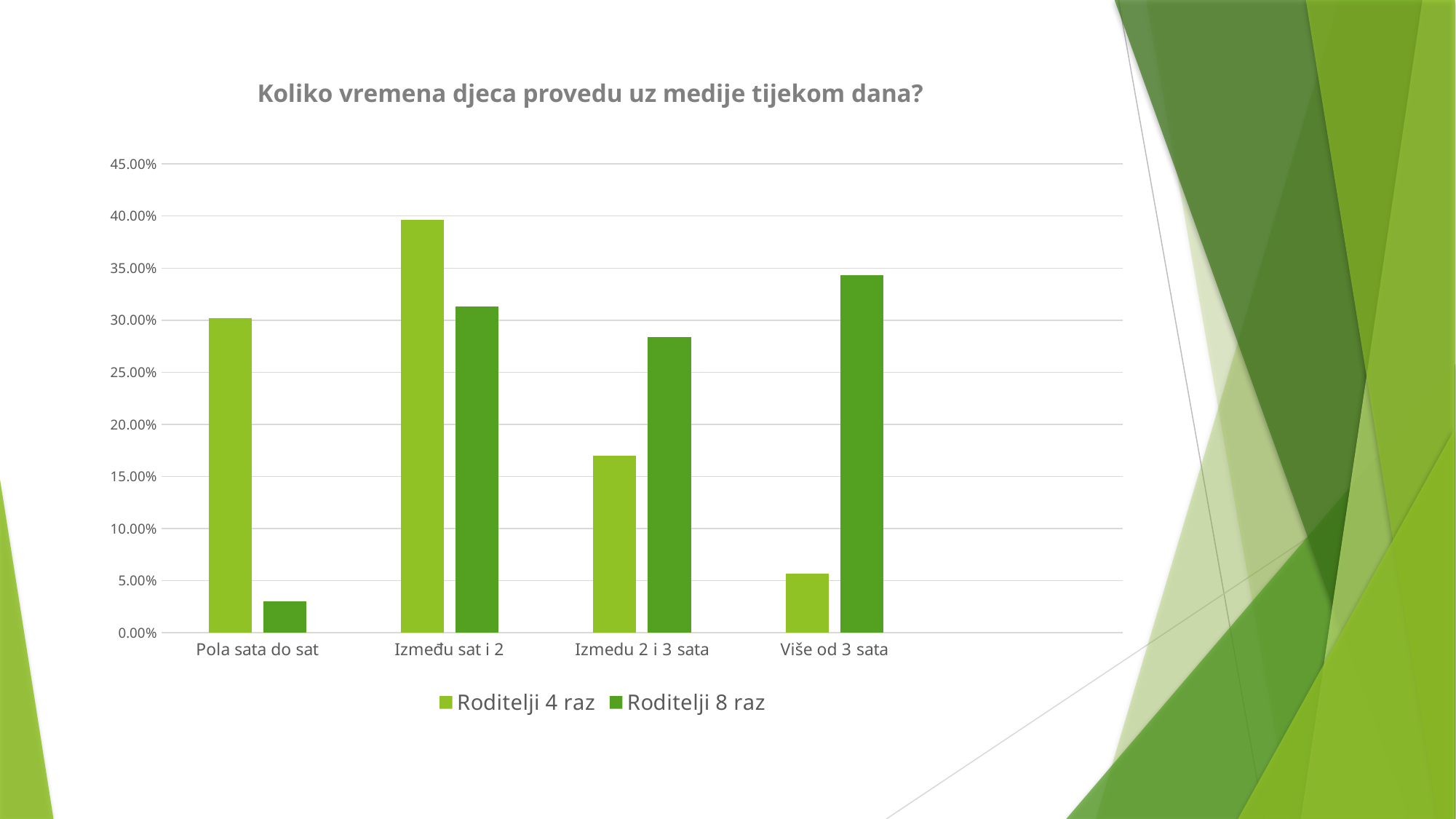
How many series does the legend list? 2 For the category Pola sata do sat, which series has the larger value, Roditelji 4 raz or Roditelji 8 raz? Roditelji 4 raz For the category Više od 3 sata, which series has the larger value, Roditelji 4 raz or Roditelji 8 raz? Roditelji 8 raz For the series Roditelji 8 raz, which category has the lowest value? Pola sata do sat How many categories are shown on the x axis? 4 For the series Roditelji 4 raz, which category has the highest value? Između sat i 2 For the series Roditelji 4 raz, which category has the lowest value? Više od 3 sata Is the value for Roditelji 8 raz in the category Izmedu 2 i 3 sata greater or less than 30.00%? less What is the title of the chart? Koliko vremena djeca provedu uz medije tijekom dana? Is the value for Roditelji 4 raz in the category Između sat i 2 greater or less than 35.00%? greater What kind of chart is shown on the slide? bar chart Is the value for Roditelji 8 raz in the category Pola sata do sat greater or less than 5.00%? less